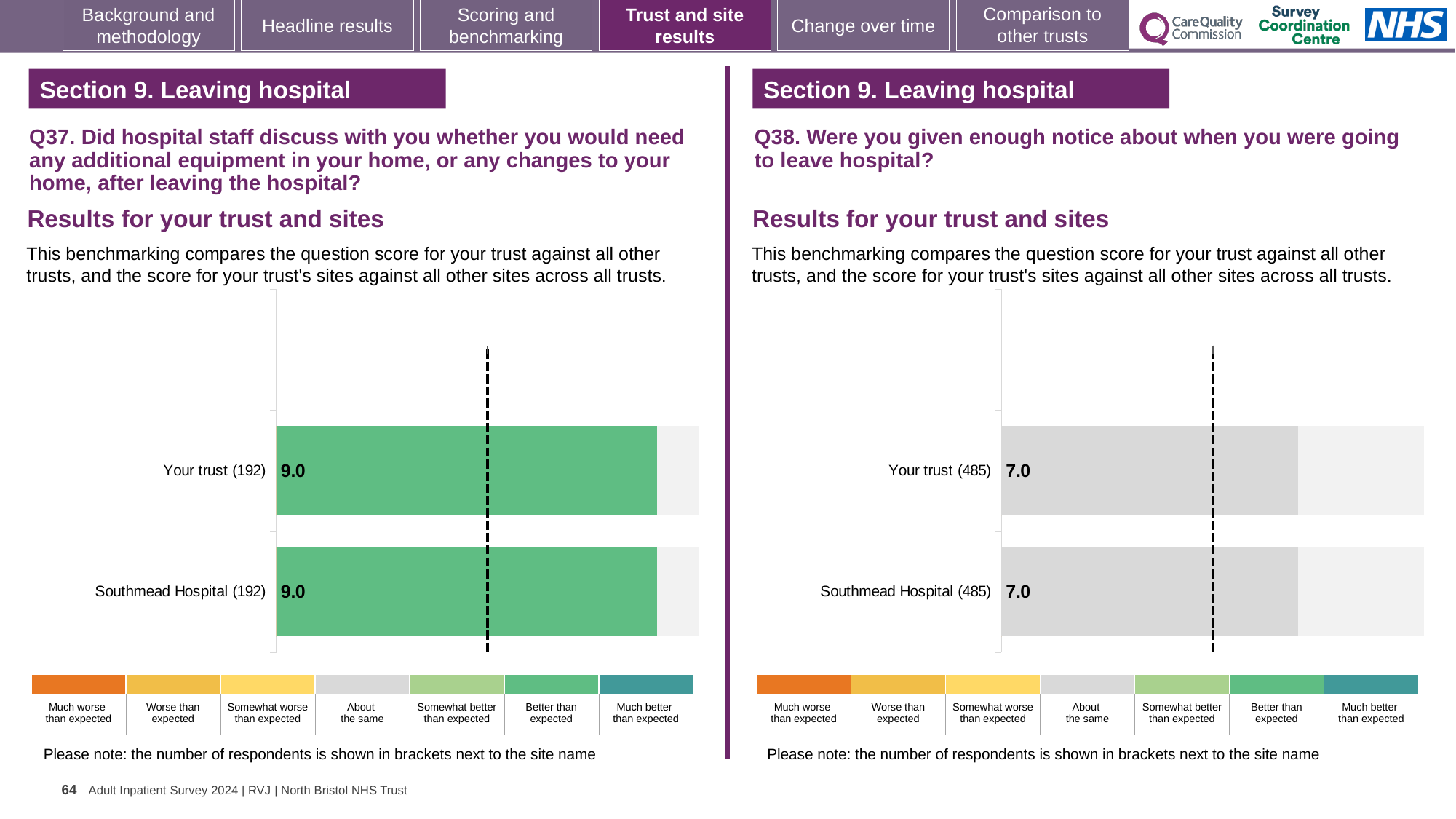
On the Q38 chart (right), what is the score for Your trust? 7.0 On the Q37 chart (left), what is the difference between the scores for Your trust and Southmead Hospital? 0.0 On the Q38 chart (right), what is the difference between the scores for Your trust and Southmead Hospital? 0.0 On the Q38 chart (right), what is the score for Southmead Hospital? 7.0 On the Q38 chart (right), how many respondents are shown in brackets for Southmead Hospital? 485 How many bars are plotted on the Q37 chart (left)? 2 On the Q37 chart (left), what is the score for Your trust? 9.0 How many bars are plotted on the Q38 chart (right)? 2 What type of chart is used on the Q37 chart (left)? Bar chart On the Q37 chart (left), what is the score for Southmead Hospital? 9.0 According to the colour key, which benchmark category do the grey bars on the Q38 chart (right) represent? About the same On the Q37 chart (left), how many respondents are shown in brackets for Your trust? 192